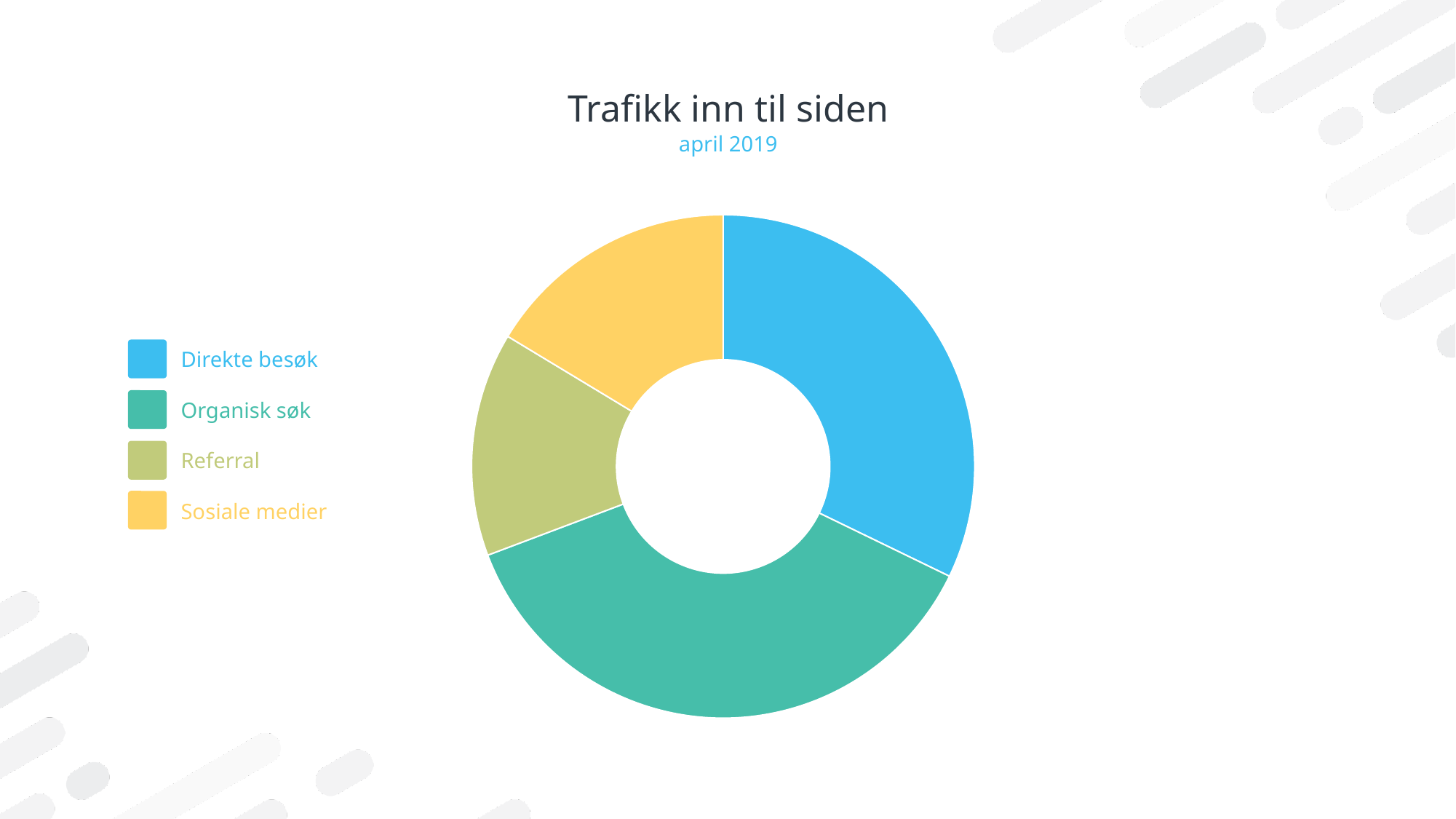
What kind of chart is shown on the slide? Pie chart (donut) Which is larger, the share for Direkte besøk or the share for Sosiale medier? Direkte besøk Which period does the chart cover, according to the subtitle? april 2019 Which is larger, the share for Organisk søk or the share for Sosiale medier? Organisk søk What is the title of the chart? Trafikk inn til siden Which category has the largest share of the chart? Organisk søk How many categories does the chart show? 4 Which is larger, the share for Direkte besøk or the share for Referral? Direkte besøk How many entries does the legend list? 4